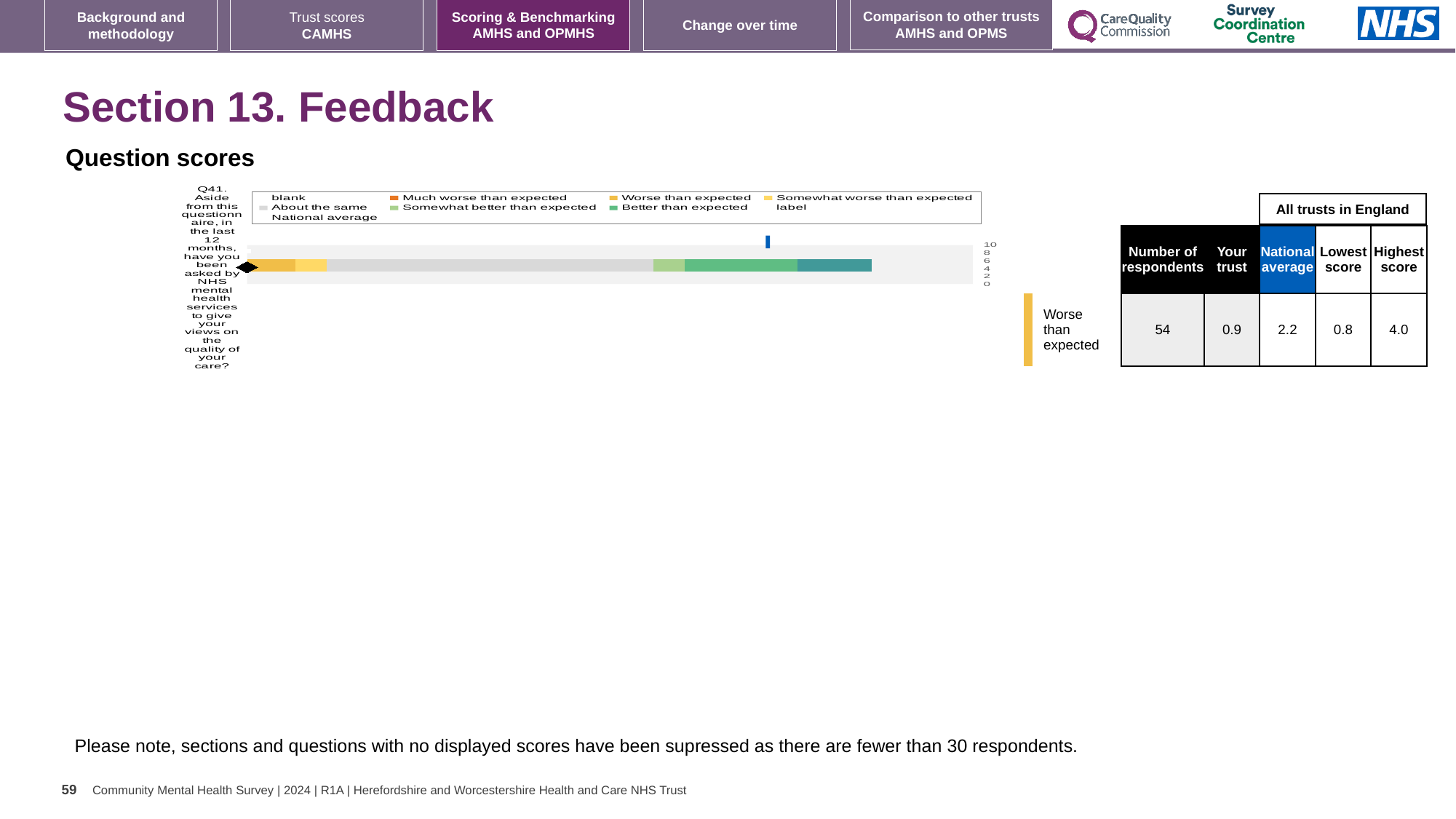
How many entries does the legend of the Question scores chart list? 9 Which question is plotted in the Question scores chart? Q41. Aside from this questionnaire, in the last 12 months, have you been asked by NHS mental health services to give your views on the quality of your care? For Q41, which is larger: the trust's score or the national average? National average In the table beside the Question scores chart, what is the national average for Q41? 2.2 In the table beside the Question scores chart, what is the lowest score among all trusts in England for Q41? 0.8 What kind of chart is used to show the Q41 question score? Bar chart Is the trust's score marker for Q41 in the Question scores chart greater or less than 2? less How many questions (categories) are plotted in the Question scores chart? 1 In the table beside the Question scores chart, how many respondents answered Q41? 54 In the table beside the Question scores chart, what is the trust's score for Q41? 0.9 In the table beside the Question scores chart, what is the highest score among all trusts in England for Q41? 4.0 What benchmark rating is shown beside the Q41 bar in the Question scores chart? Worse than expected